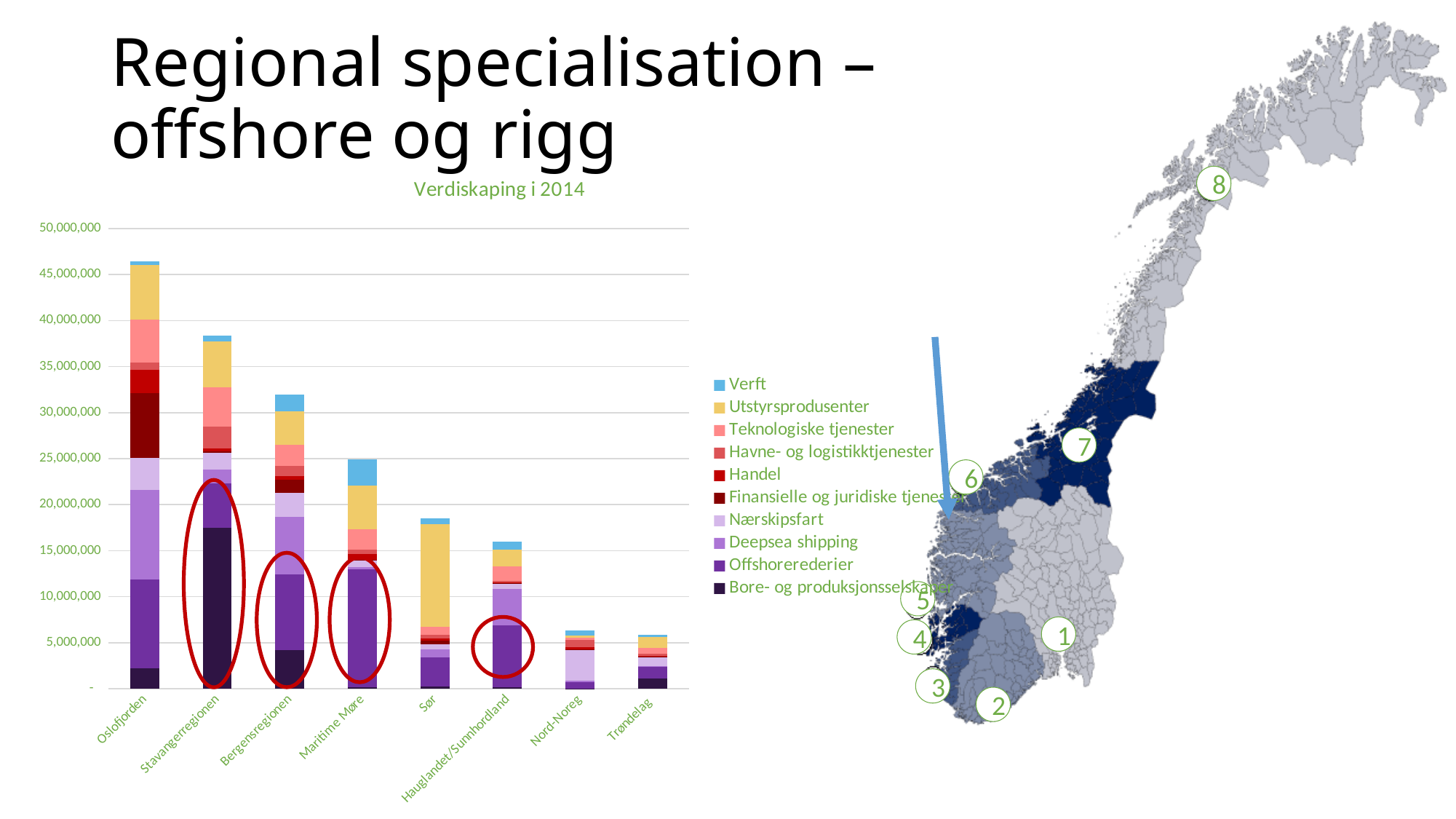
Is the total value for Oslofjorden greater or less than 40,000,000? greater Which region has the highest total value in the chart? Oslofjorden What is the title of the chart? Verdiskaping i 2014 Is the total value for Sør greater or less than 20,000,000? less Is the total value for Bergensregionen greater or less than 30,000,000? greater Do the total bar values generally rise or fall moving from left to right along the x axis? fall How many series does the chart legend list? 10 Which has a larger total value, Bergensregionen or Maritime Møre? Bergensregionen How many regions (categories) are shown on the x axis of the chart? 8 What kind of chart is shown on the slide? Stacked bar chart